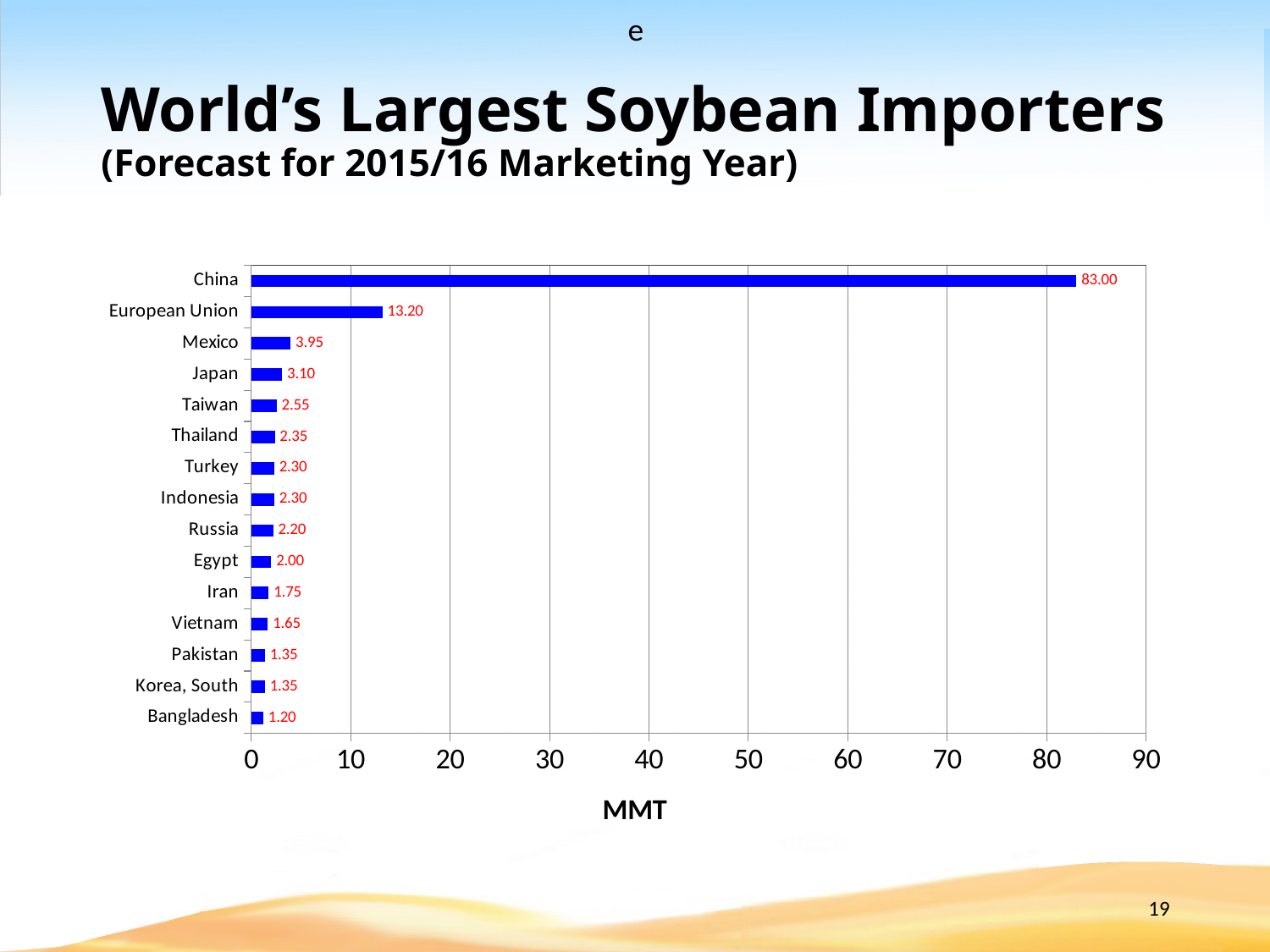
Is the value for the European Union greater or less than 10? greater Which importer has the lowest value on the chart? Bangladesh What is the difference between the values for Mexico and Japan? 0.85 How many importers are listed on the chart? 15 What is the difference between the values for China and the European Union? 69.80 What kind of chart is shown on the slide? bar chart Which importer has the highest value on the chart? China What unit is labelled on the x axis of the chart? MMT What is the value shown for Japan? 3.10 What is the forecast soybean import value for China? 83.00 What is the value shown for the European Union? 13.20 Which has a larger value, Taiwan or Egypt? Taiwan